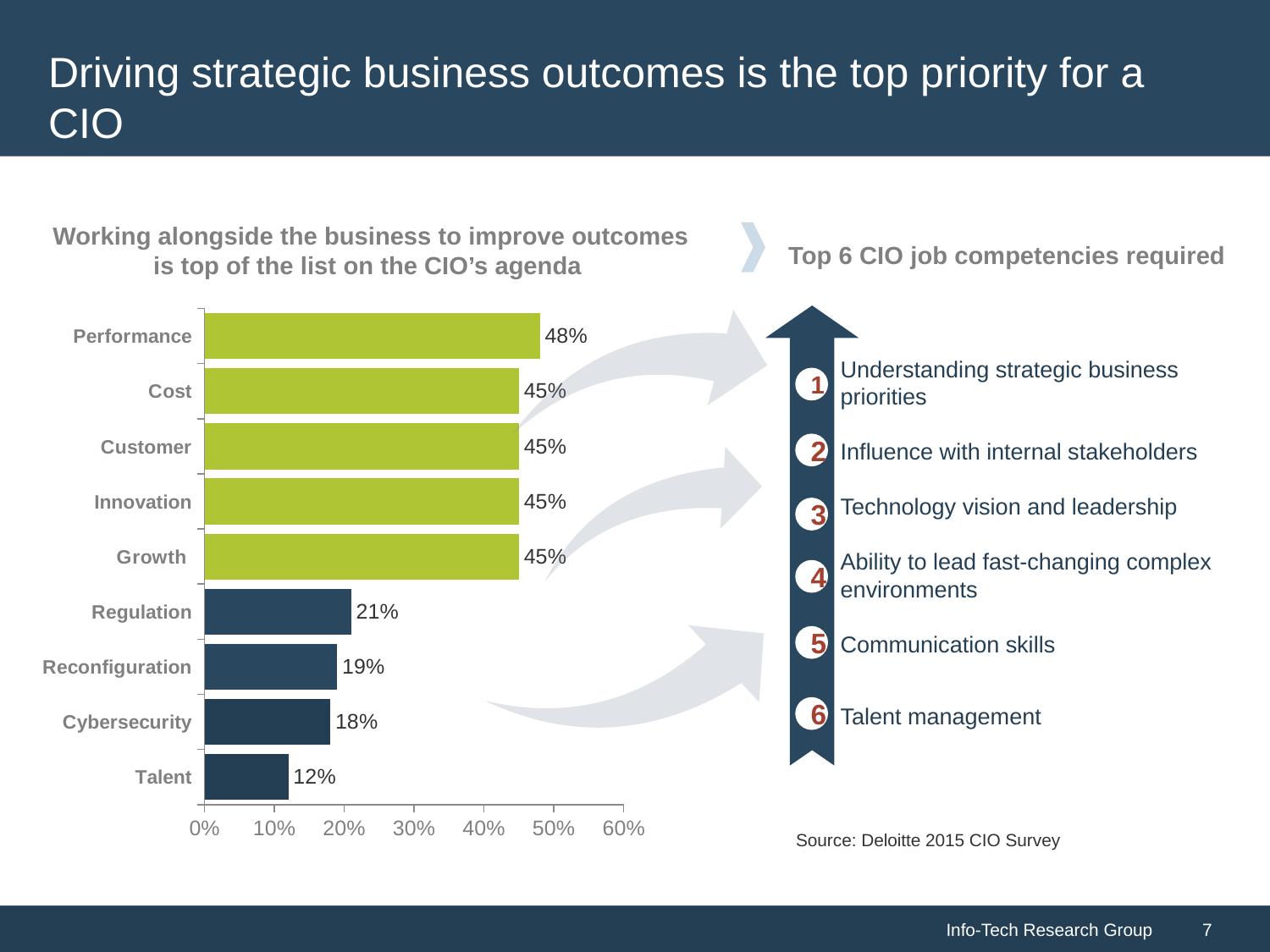
What is the difference between the values for Performance and Talent? 36% What kind of chart is shown on the slide? Bar chart What is the value for Cybersecurity? 18% Which is larger, the value for Growth or the value for Regulation? Growth How many categories share the value 45%? 4 What is the value for Performance? 48% Which category has the highest value? Performance What is the value for Regulation? 21% What is the difference between the values for Regulation and Reconfiguration? 2% Which category has the lowest value? Talent What is the title of the chart? Working alongside the business to improve outcomes is top of the list on the CIO's agenda How many categories are shown in the bar chart? 9